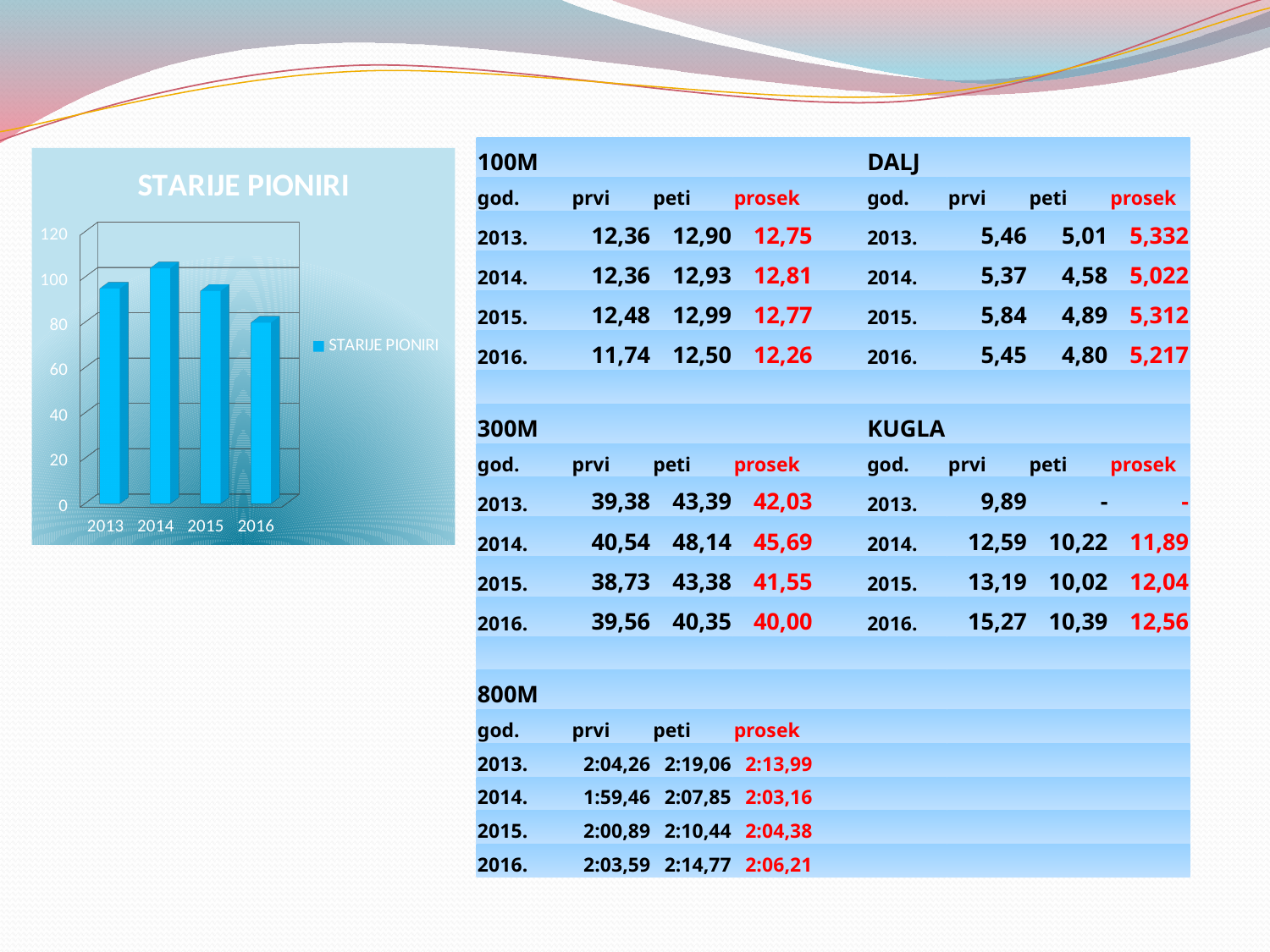
Is the value for 2014 greater or less than 100? greater What is the title of the chart? STARIJE PIONIRI What kind of chart is shown on the slide? bar chart Which is larger, the value for 2014 or the value for 2016? 2014 Is the value for 2013 greater or less than 80? greater How many series does the chart legend list? 1 How many years are shown on the x axis of the chart? 4 Which year has the highest bar in the chart? 2014 What is the name of the series shown in the chart legend? STARIJE PIONIRI Which year has the lowest bar in the chart? 2016 Is the value for 2016 greater or less than 60? greater